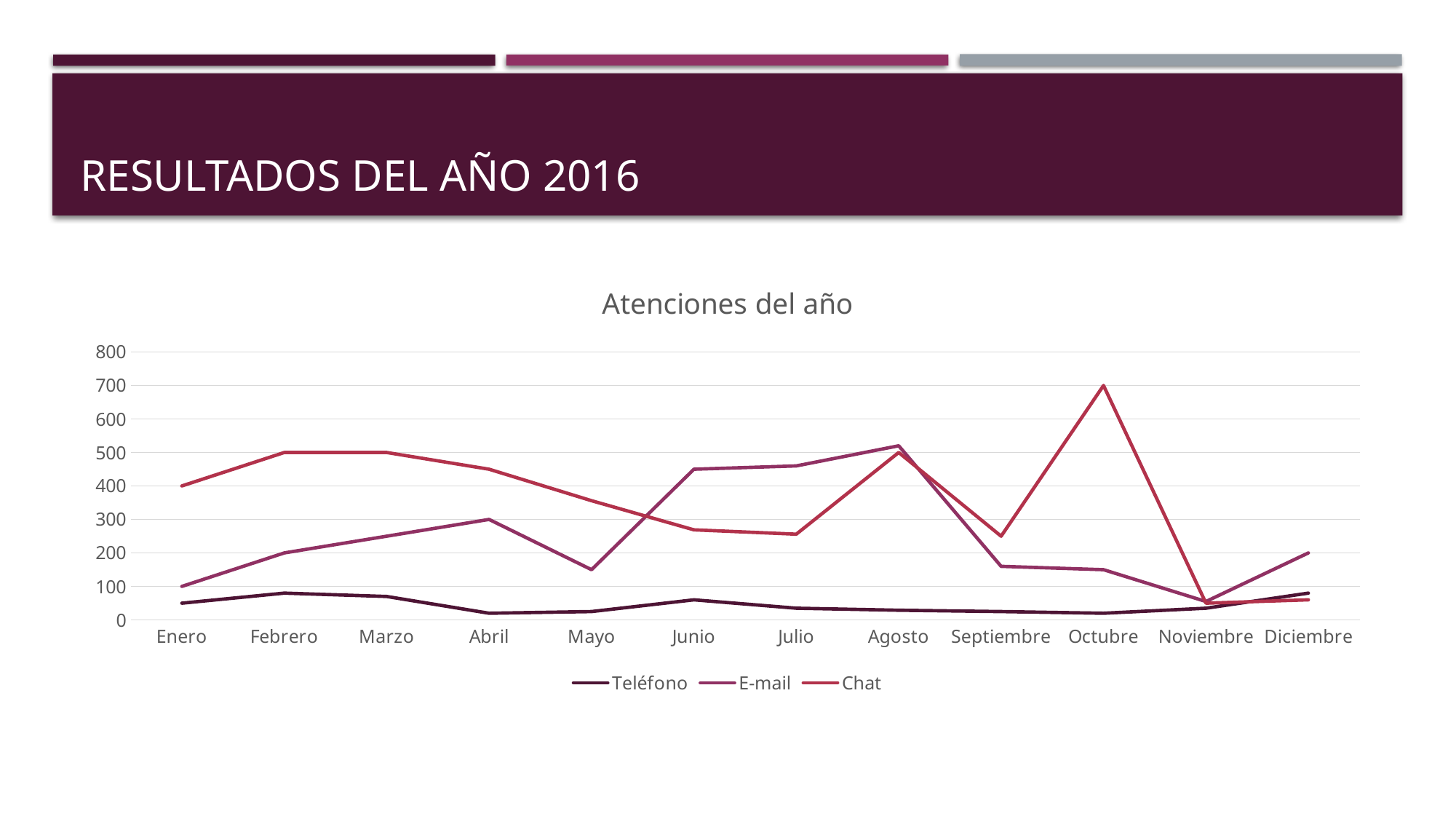
In which month does the Chat series reach its highest value? Octubre How many series does the legend of the chart list? 3 How many months are shown along the x axis of the chart? 12 Does the Chat series rise or fall from Octubre to Noviembre? fall In which month does the E-mail series reach its highest value? Agosto Which is larger in Junio, the value for E-mail or the value for Chat? E-mail Is the value for E-mail in Mayo greater or less than 200? less What kind of chart is shown on the slide? line chart What is the value for E-mail in Abril? 300 What is the value for Chat in Febrero? 500 What is the value for Chat in Octubre? 700 What is the title of the chart? Atenciones del año